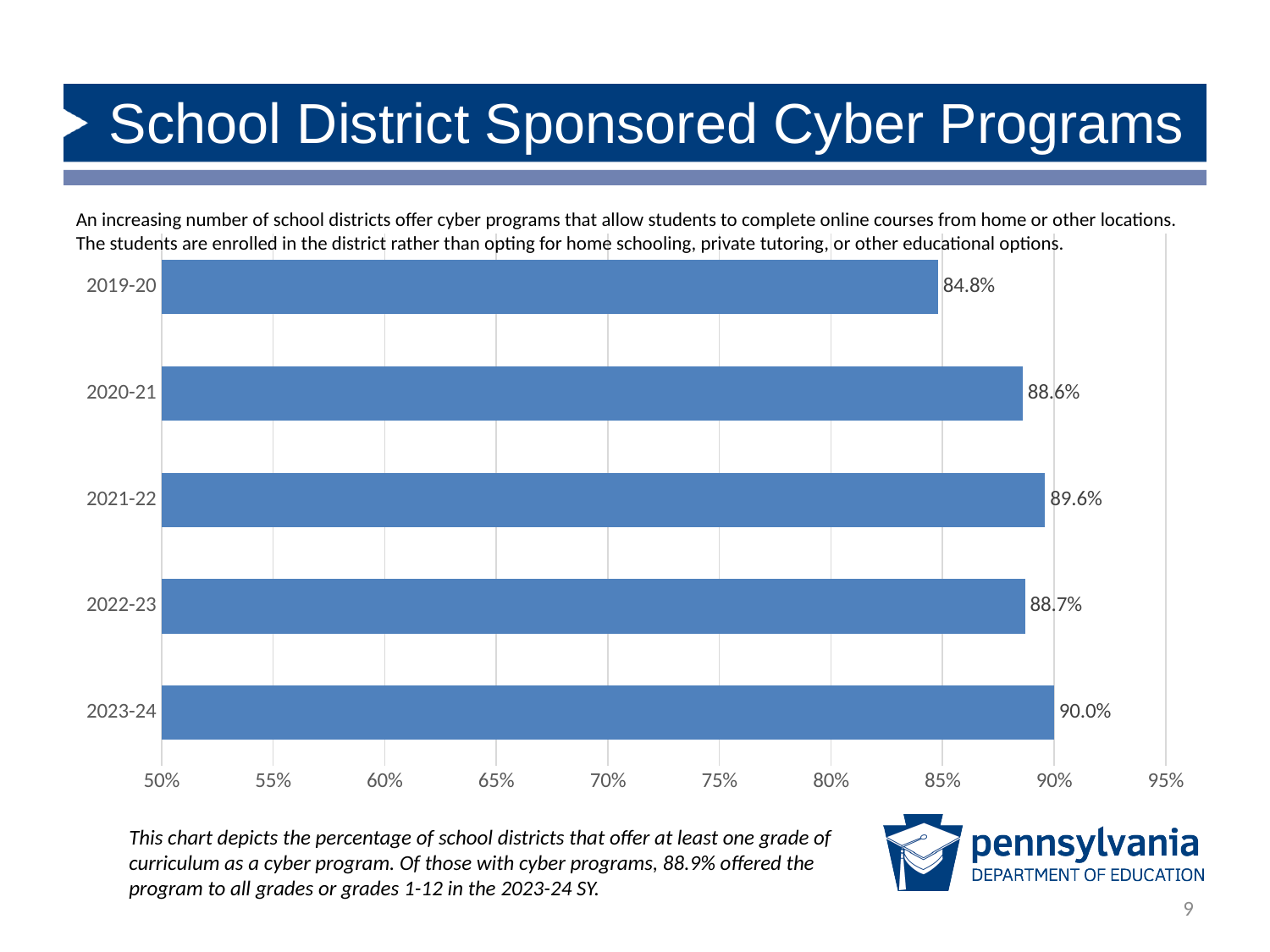
What is the difference between the values for 2021-22 and 2020-21? 1.0% What is the title of the slide containing the chart? School District Sponsored Cyber Programs What is the difference between the values for 2023-24 and 2019-20? 5.2% Which school year has the lowest value? 2019-20 What is the value for 2021-22? 89.6% What is the value for 2019-20? 84.8% Which is larger, the value for 2021-22 or the value for 2022-23? 2021-22 What kind of chart is shown on the slide? bar chart How many school years are shown in the chart? 5 Is the value for 2019-20 greater or less than 85%? less Which school year has the highest value? 2023-24 What is the value for 2023-24? 90.0%